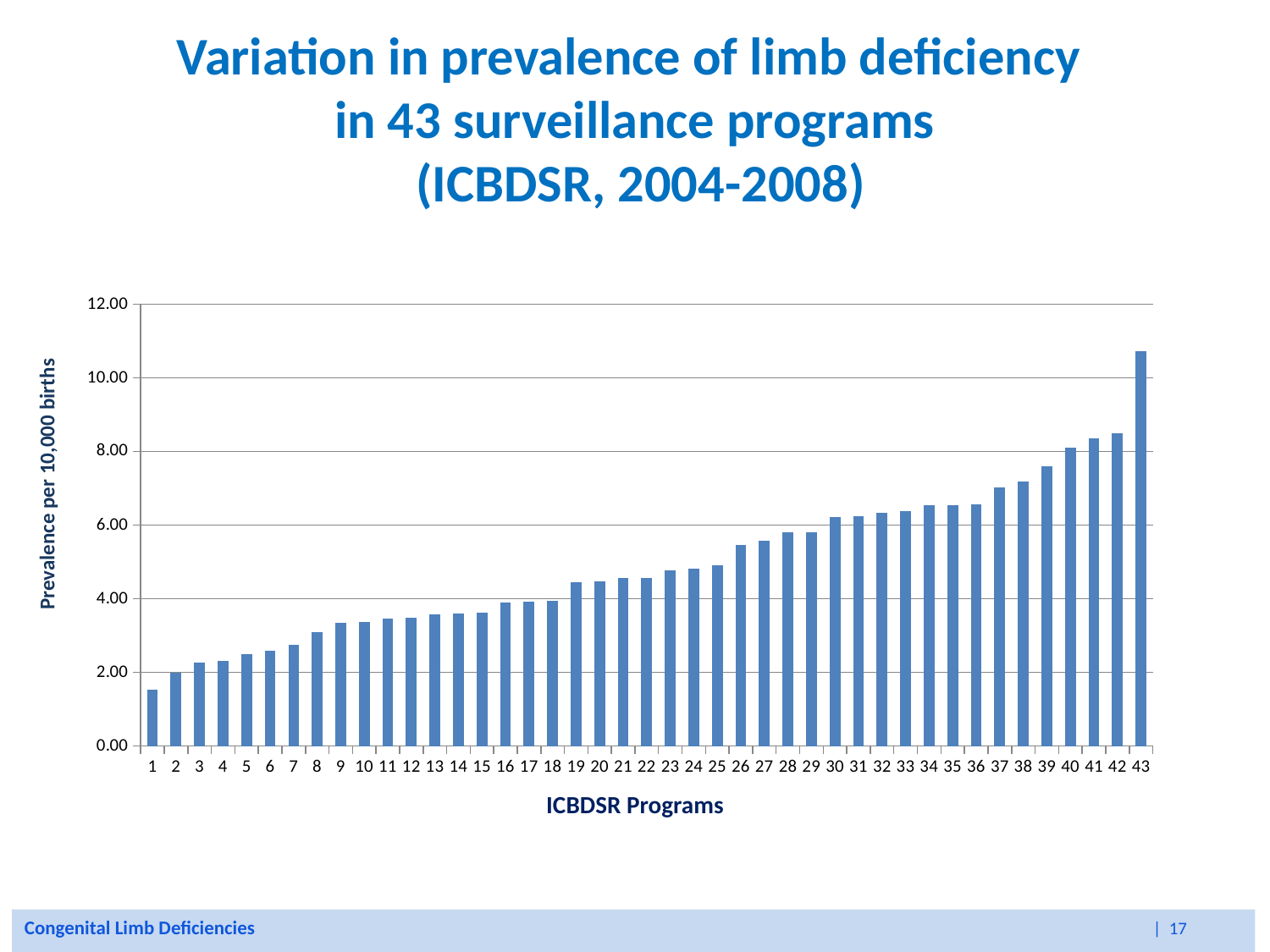
What is the label of the y axis? Prevalence per 10,000 births What kind of chart is shown on the slide? bar chart Is the value for program 25 greater or less than 6.00? less How many ICBDSR programs are plotted on the x axis? 43 Which program has the highest prevalence per 10,000 births? 43 Which has the larger prevalence, program 1 or program 2? program 2 Is the value for program 43 greater or less than 10.00? greater Is the value for program 20 greater or less than 4.00? greater Do the prevalence values rise or fall from program 1 to program 43? rise Which program has the lowest prevalence per 10,000 births? 1